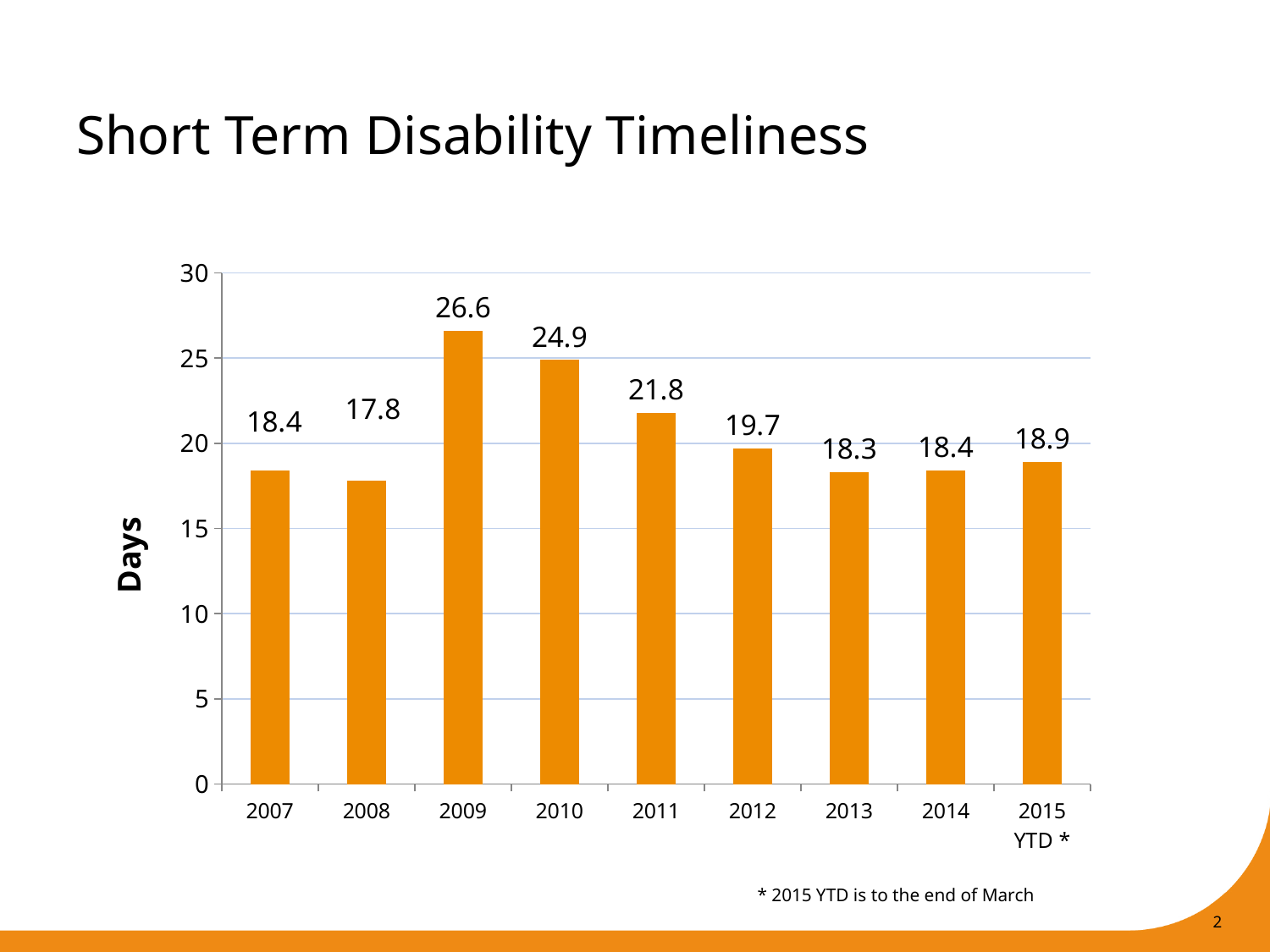
Which is larger, the value for 2010 or the value for 2011? 2010 How many years are shown on the x axis? 9 What is the value for 2009? 26.6 What is the value for 2015 YTD? 18.9 What is the label of the vertical axis? Days Which year has the highest value? 2009 Is the value for 2013 greater or less than 20? less What is the value for 2012? 19.7 What is the difference between the values for 2011 and 2012? 2.1 Which year has the lowest value? 2008 What is the difference between the values for 2009 and 2010? 1.7 What kind of chart is shown on the slide? bar chart